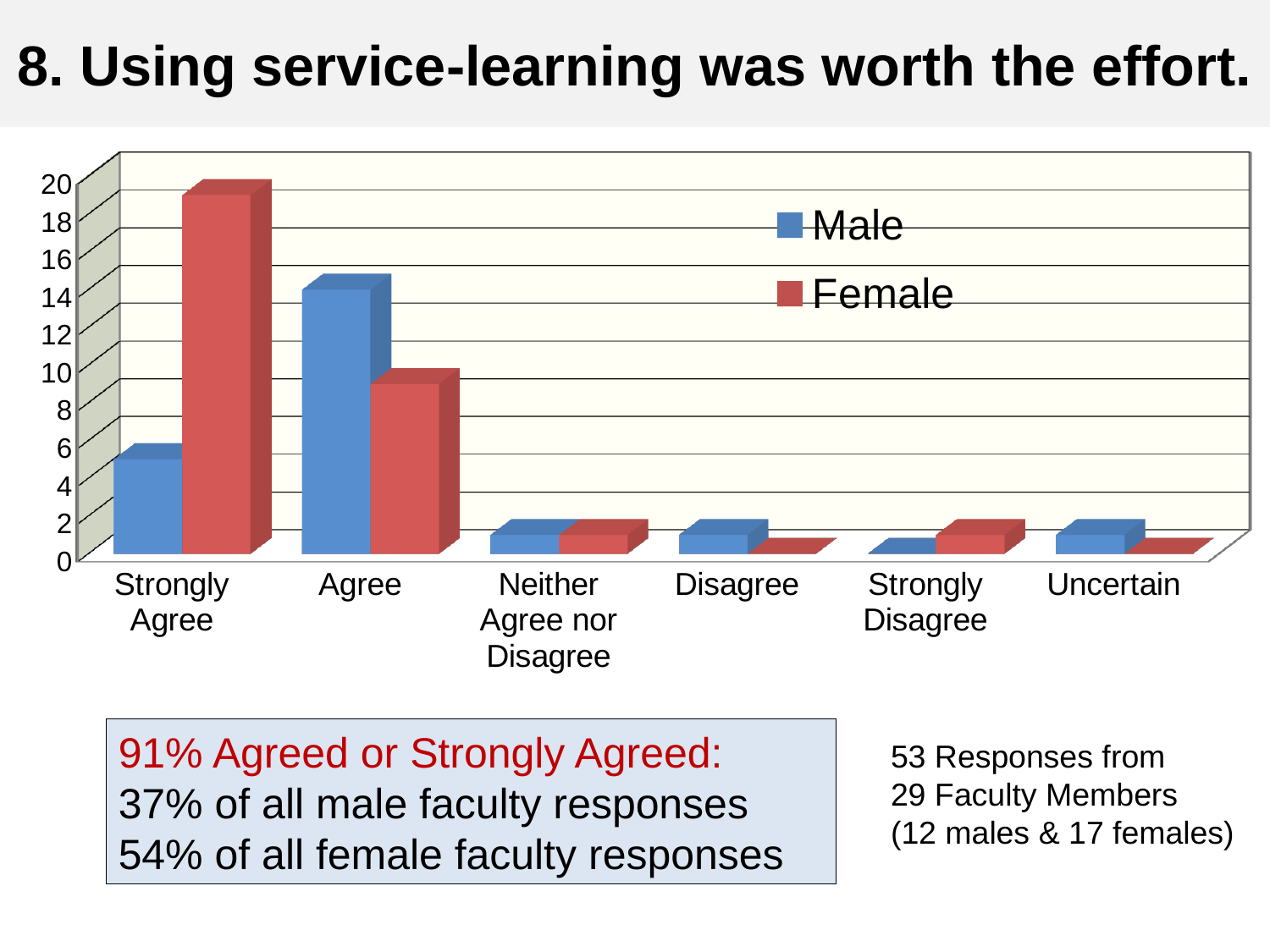
For Agree, which is larger, the Male value or the Female value? Male Is the Male value for Agree greater or less than 12? greater How many series does the legend list? 2 Which category has the highest Female value? Strongly Agree What colour are the Female bars in the chart? red Is the Female value for Strongly Agree greater or less than 16? greater Is the Male value for Strongly Agree greater or less than 8? less For Strongly Agree, which is larger, the Male value or the Female value? Female Which category has the highest Male value? Agree How many response categories are shown on the x axis? 6 What kind of chart is shown on the slide? bar chart